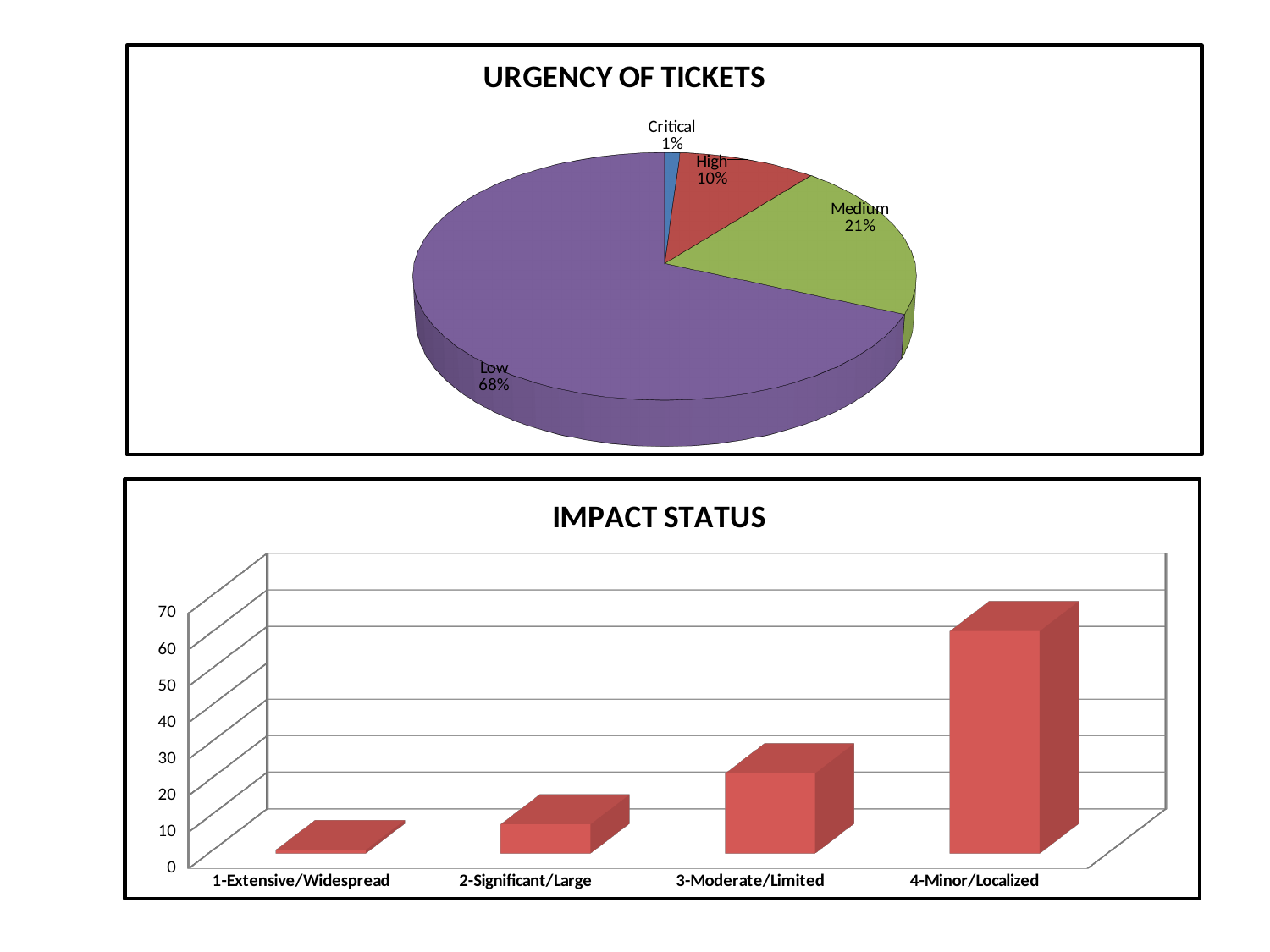
In the IMPACT STATUS chart, do the values rise or fall from left to right along the x axis? Rise In the URGENCY OF TICKETS chart, what percentage of tickets is Critical? 1% In the URGENCY OF TICKETS chart, what percentage of tickets is Medium urgency? 21% In the URGENCY OF TICKETS chart, which urgency level has the smallest share? Critical In the URGENCY OF TICKETS chart, what is the difference in percentage points between Medium and High? 11 In the URGENCY OF TICKETS chart, which urgency level has the largest share? Low What kind of chart is the IMPACT STATUS chart? Bar chart What kind of chart is the URGENCY OF TICKETS chart? Pie chart In the IMPACT STATUS chart, is the value for 4-Minor/Localized greater or less than 50? greater In the URGENCY OF TICKETS chart, how many slices does the pie have? 4 In the URGENCY OF TICKETS chart, what share of tickets is Low urgency? 68% In the IMPACT STATUS chart, which category has the highest value? 4-Minor/Localized